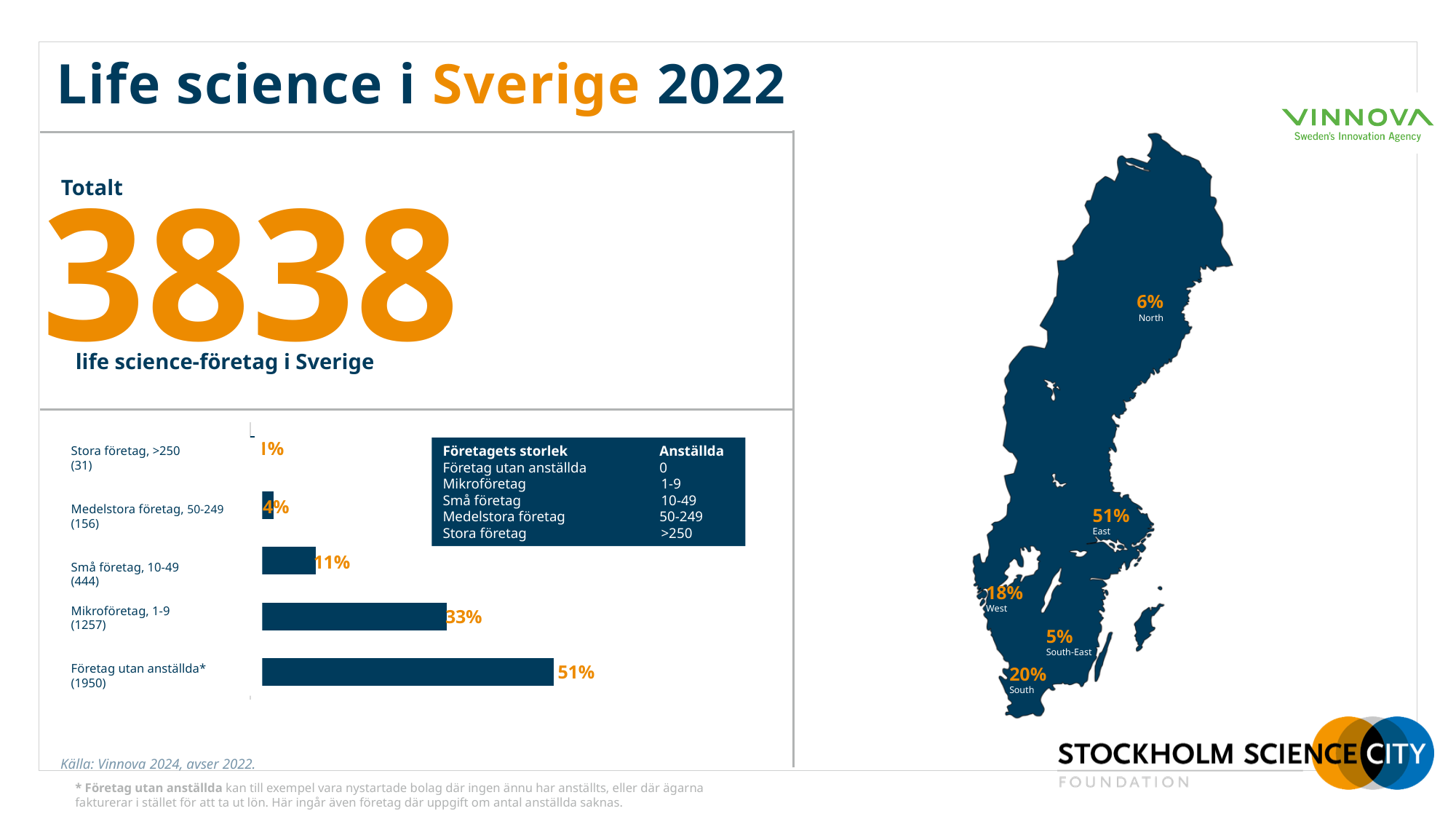
In the bar chart, which is larger: Små företag, 10-49 or Medelstora företag, 50-249? Små företag, 10-49 What percentage does the bar chart show for Medelstora företag, 50-249? 4% How many categories does the bar chart show? 5 What total number of life science companies in Sweden is shown above the bar chart? 3838 What percentage does the bar chart show for Mikroföretag, 1-9? 33% Which category has the lowest percentage in the bar chart? Stora företag, >250 Which category has the highest percentage in the bar chart? Företag utan anställda What percentage does the bar chart show for Små företag, 10-49? 11% What is the difference in percentage points between Företag utan anställda and Mikroföretag, 1-9 in the bar chart? 18 What percentage does the bar chart show for Stora företag, >250? 1% How many companies are listed in parentheses for Mikroföretag, 1-9 in the bar chart? 1257 What kind of chart is shown on the left side of the slide? bar chart